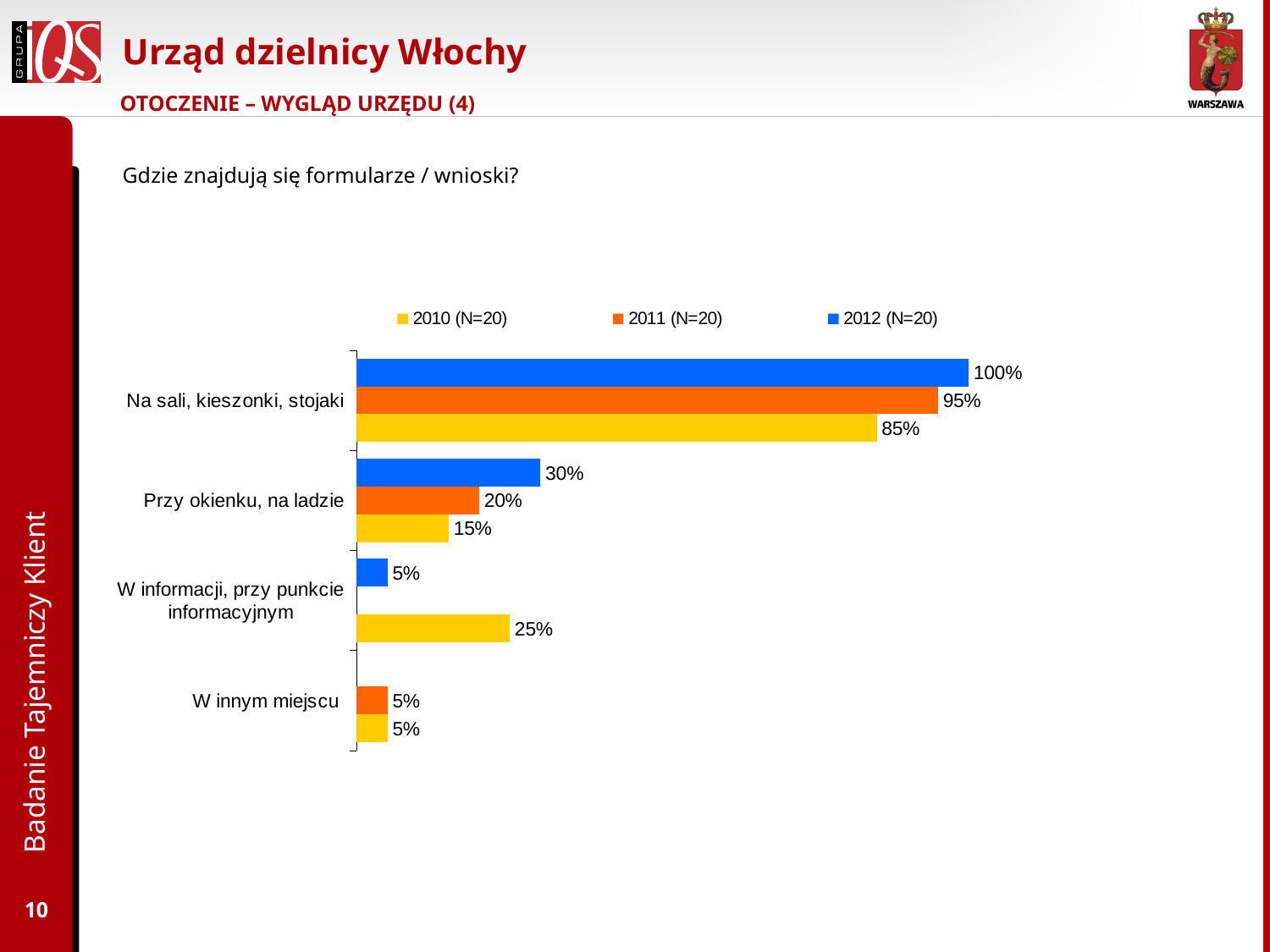
What question does the chart answer, as stated above it? Gdzie znajdują się formularze / wnioski? What is the value for 'Na sali, kieszonki, stojaki' in the 2012 (N=20) series? 100% What is the value for 'W informacji, przy punkcie informacyjnym' in the 2010 (N=20) series? 25% Which is larger for 'Przy okienku, na ladzie': the 2012 (N=20) value or the 2010 (N=20) value? 2012 (N=20) How many series does the legend list? 3 What is the value for 'W innym miejscu' in the 2011 (N=20) series? 5% How many categories are shown on the chart? 4 What kind of chart is shown on the slide? Bar chart Which category has the highest value in the 2010 (N=20) series? Na sali, kieszonki, stojaki What is the value for 'Przy okienku, na ladzie' in the 2011 (N=20) series? 20% What is the difference between the 2012 (N=20) and 2010 (N=20) values for 'Na sali, kieszonki, stojaki'? 15%